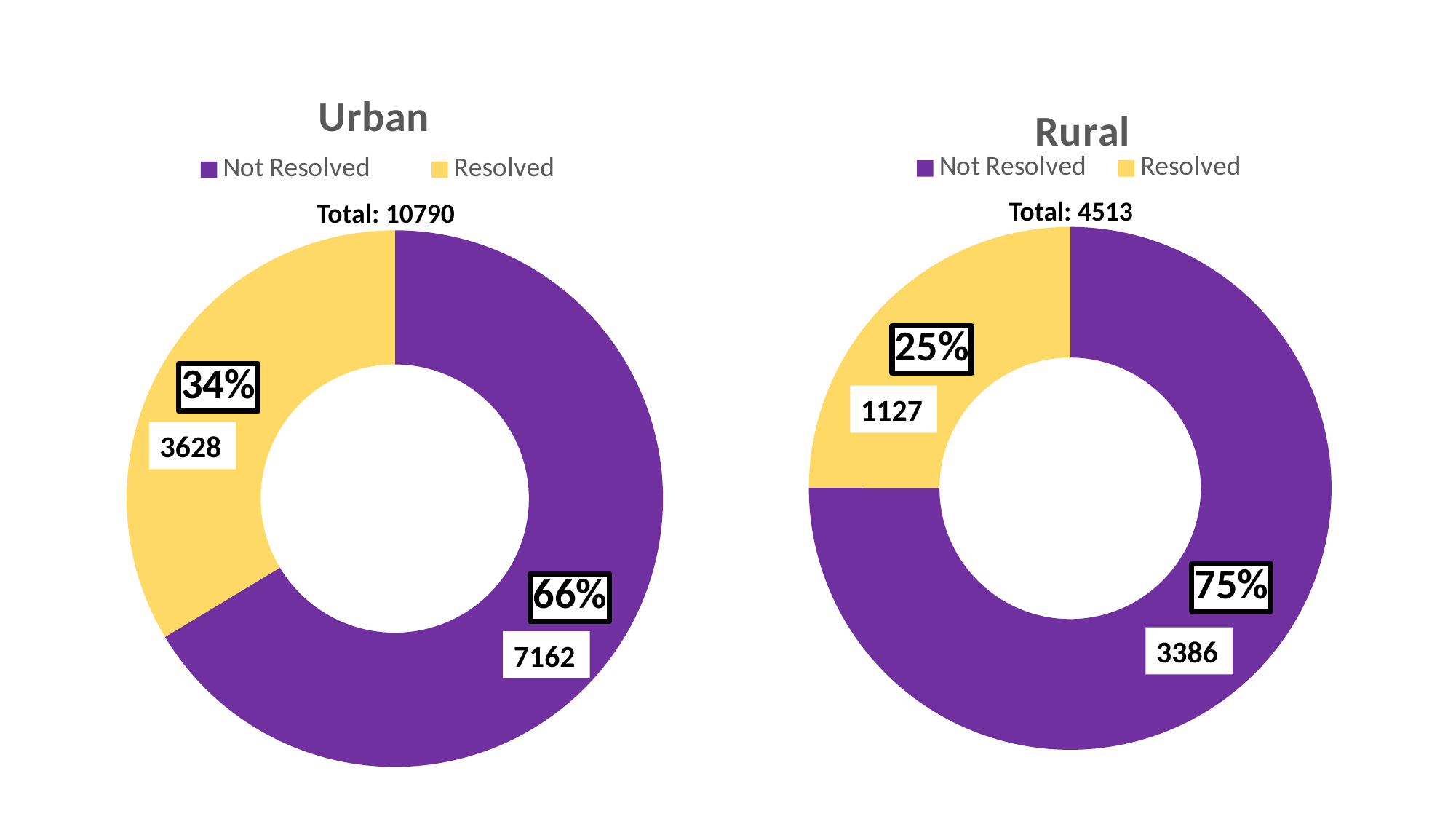
In the Urban chart, what is the difference between Not Resolved and Resolved? 3534 In the Rural chart, what is the value for Not Resolved? 3386 How many entries does the legend of the Rural chart list? 2 In the Urban chart, what is the value for Not Resolved? 7162 In the Rural chart, which category is the smallest? Resolved In the Urban chart, what is the value for Resolved? 3628 What kind of chart is the Urban chart? Pie chart (doughnut) In the Rural chart, what share of the total is Not Resolved? 75% In the Rural chart, what is the total shown? 4513 In the Urban chart, which category is the largest? Not Resolved In the Rural chart, what is the value for Resolved? 1127 In the Urban chart, what share of the total is Resolved? 34%